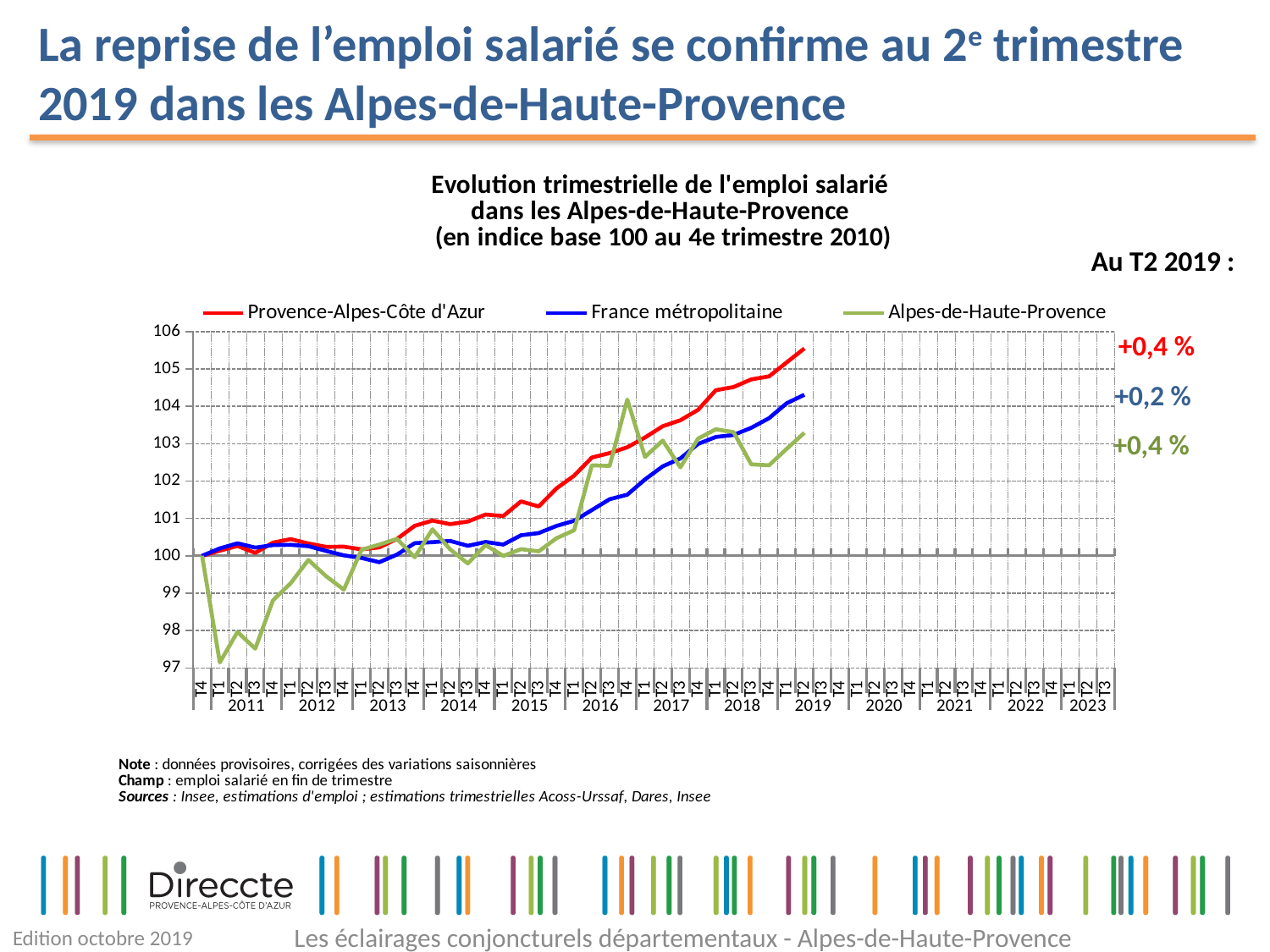
Which series are listed in the chart legend? Provence-Alpes-Côte d'Azur, France métropolitaine, Alpes-de-Haute-Provence What is the base period of the index used in the chart? 4e trimestre 2010 (base 100) Does the Provence-Alpes-Côte d'Azur line rise or fall between 2015 and T2 2019? rise At T2 2019, which series is higher: Provence-Alpes-Côte d'Azur or France métropolitaine? Provence-Alpes-Côte d'Azur Which series has the lowest value at T1 2011? Alpes-de-Haute-Provence Is the value for Provence-Alpes-Côte d'Azur at T2 2019 greater or less than 105? greater According to the annotation 'Au T2 2019', what is the quarterly change for Provence-Alpes-Côte d'Azur? +0,4 % Is the value for Alpes-de-Haute-Provence at T1 2011 greater or less than 98? less How many series does the legend list? 3 According to the annotation 'Au T2 2019', what is the quarterly change for France métropolitaine? +0,2 % Is the value for France métropolitaine at T2 2019 greater or less than 103? greater What kind of chart is shown on the slide? line chart